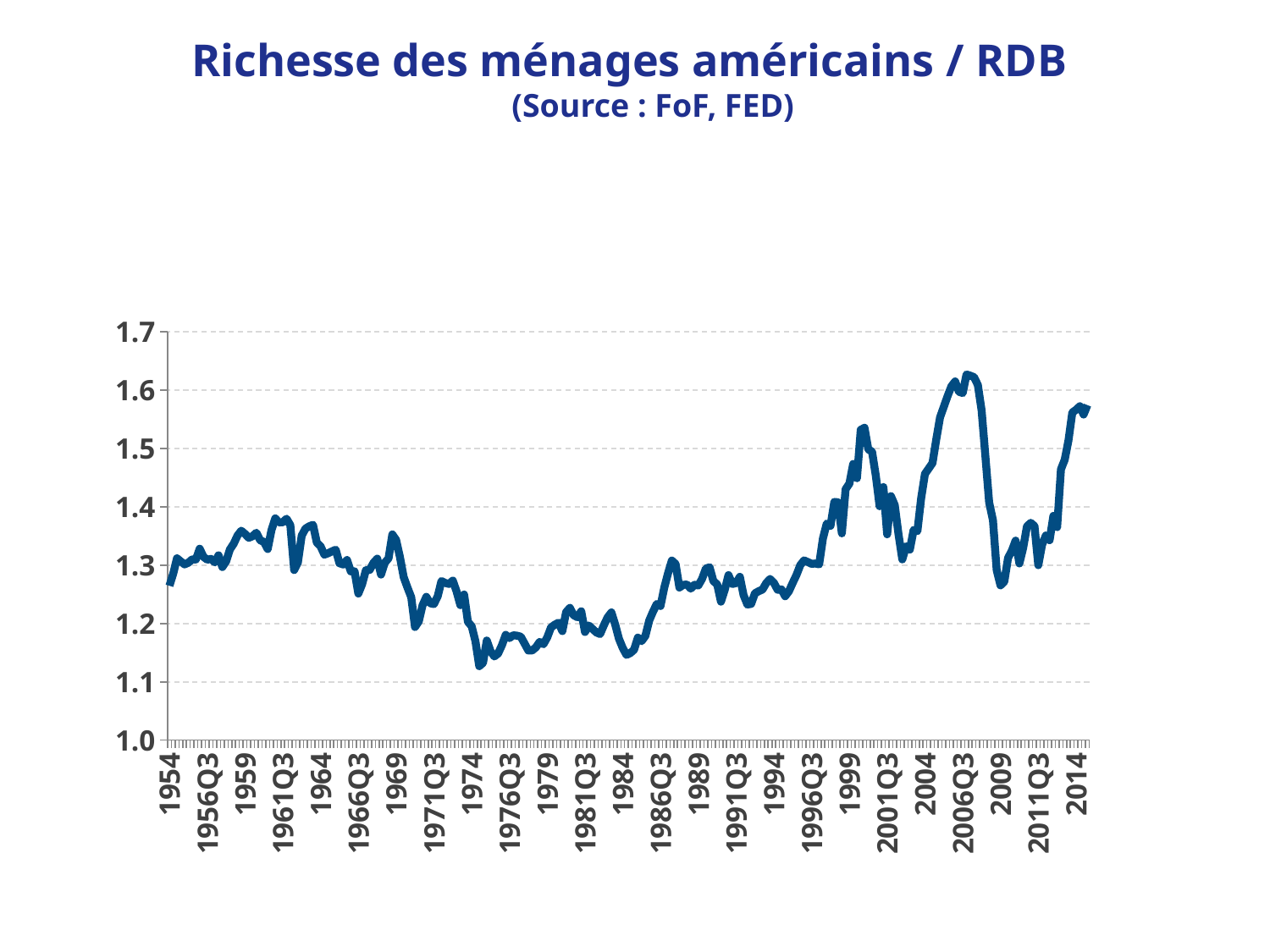
What kind of chart is shown on the slide? Line chart Does the line rise or fall between 2006Q3 and 2009? fall What is the title of the chart? Richesse des ménages américains / RDB Does the line rise or fall between 1964 and 1974? fall Is the peak around 2006Q3 higher or lower than the value at 2014? higher What source is cited under the chart title? FoF, FED Is the value at 2014 greater or less than 1.5? greater Is the value around 1984 greater or less than 1.2? less Is the value around 1974 greater or less than 1.2? less Does the line rise or fall between 1984 and 1999? rise